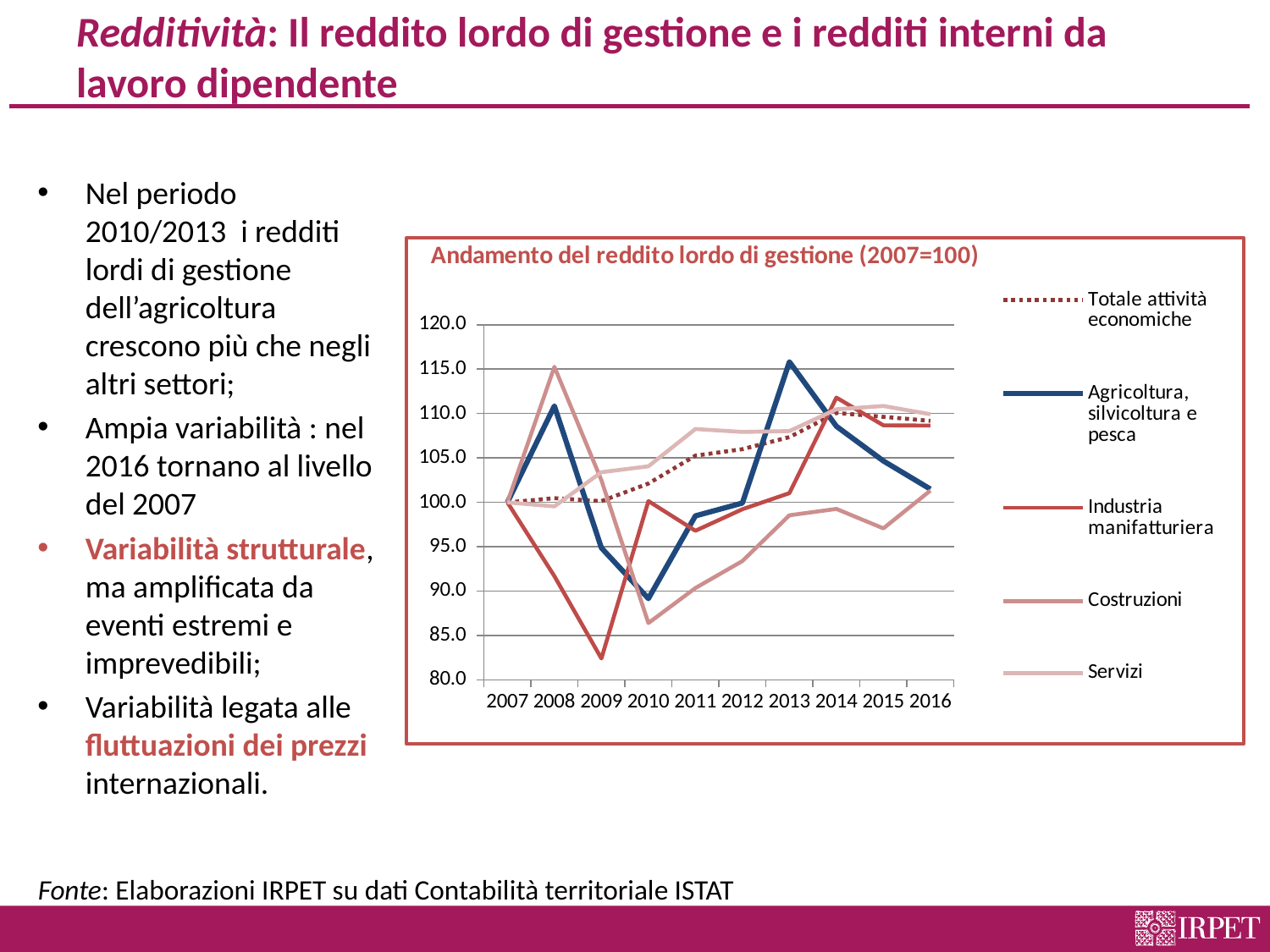
Is the value for Costruzioni in 2010 greater or less than 90? less What is the value for Agricoltura, silvicoltura e pesca in 2007? 100.0 In 2010, which is larger: the value for Industria manifatturiera or the value for Costruzioni? Industria manifatturiera What kind of chart is shown on the slide? line chart Which series has the lowest value in 2009? Industria manifatturiera How many years are plotted along the x axis of the chart? 10 What is the title of the chart? Andamento del reddito lordo di gestione (2007=100) Does the value for Agricoltura, silvicoltura e pesca rise or fall from 2013 to 2016? fall Is the value for Industria manifatturiera in 2009 greater or less than 85? less Is the value for Servizi in 2011 greater or less than 105? greater Which series has the highest value in 2013? Agricoltura, silvicoltura e pesca How many series does the legend of the chart list? 5